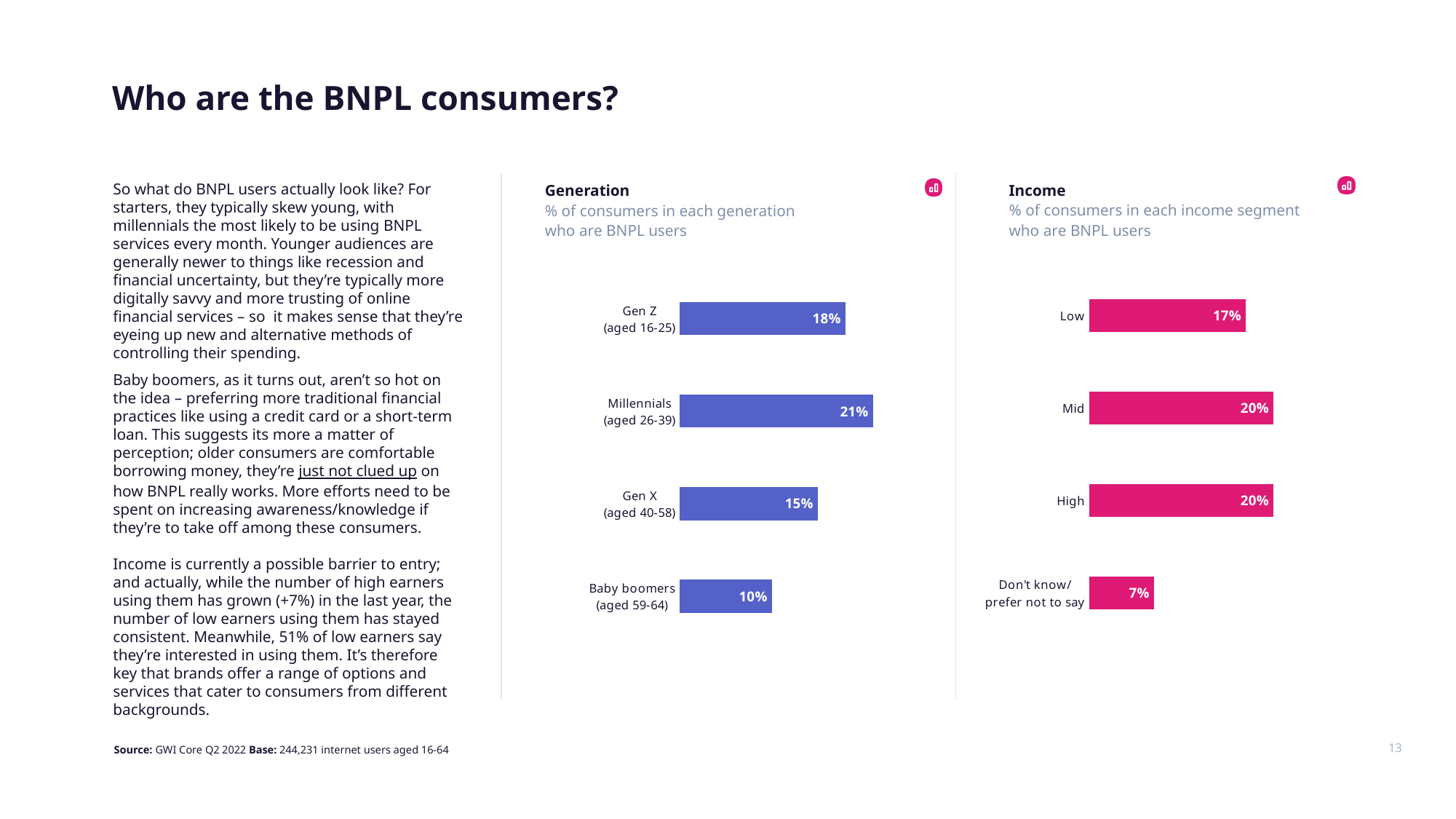
In the Income chart, which is larger, the value for Low or the value for Mid? Mid What type of chart is the Income chart? Bar chart In the Income chart, what is the value for the Low income segment? 17% In the Generation chart, which generation has the highest share of BNPL users? Millennials (aged 26-39) In the Generation chart, what percentage of Millennials (aged 26-39) are BNPL users? 21% In the Generation chart, what is the value for Baby boomers (aged 59-64)? 10% In the Generation chart, how many generations are shown? 4 In the Income chart, what is the value for Don't know/prefer not to say? 7% In the Generation chart, what is the difference between the values for Gen Z and Gen X? 3% In the Income chart, what is the difference between the values for High and Low? 3% In the Generation chart, which generation has the lowest share of BNPL users? Baby boomers (aged 59-64) In the Income chart, which segment has the lowest value? Don't know/prefer not to say